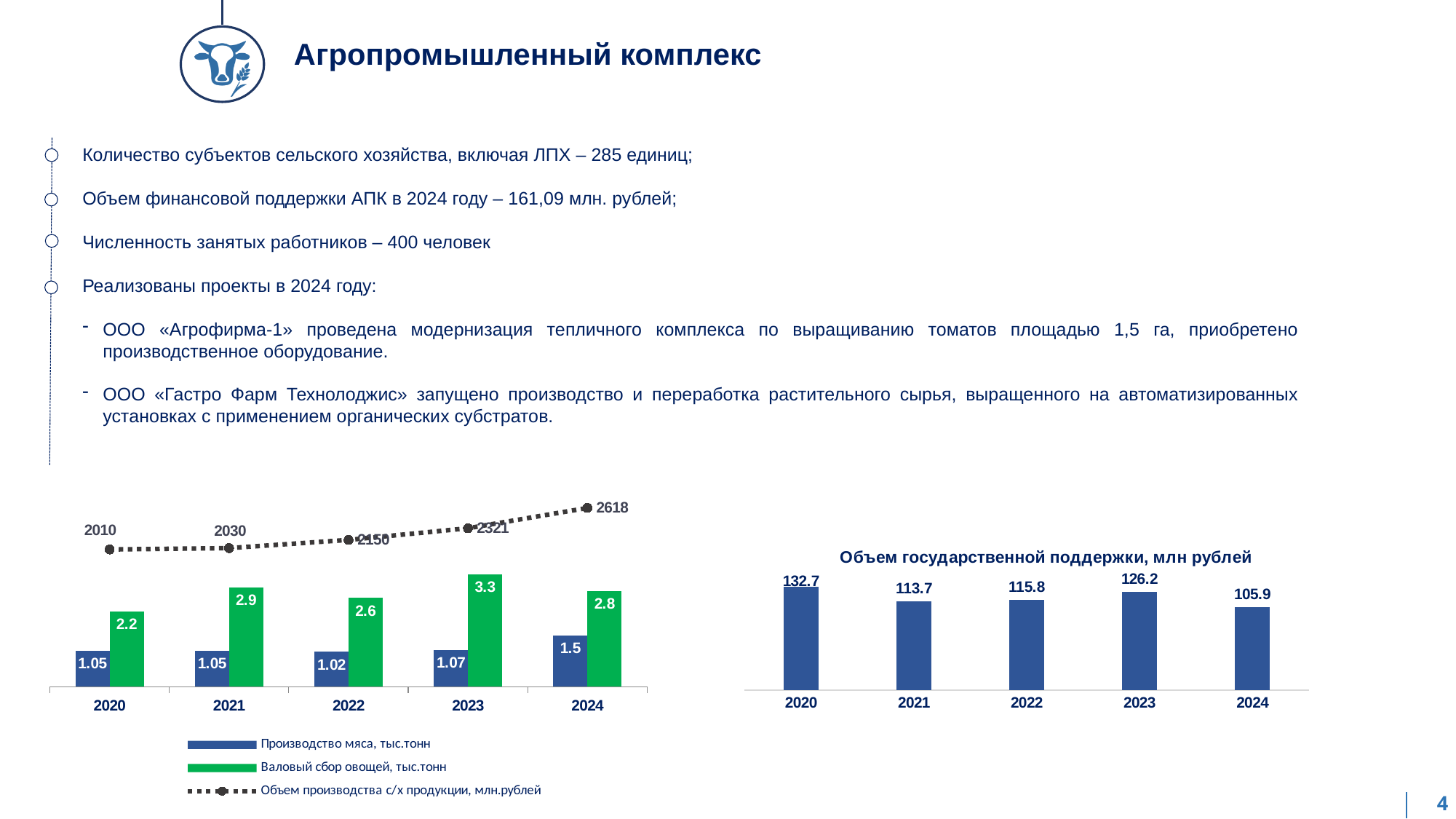
In the bottom-left chart, which is larger: 'Валовый сбор овощей, тыс.тонн' in 2021 or in 2022? 2021 In the bottom-left chart, how many series does the legend list? 3 In the chart titled 'Объем государственной поддержки, млн рублей', what is the value for 2023? 126.2 In the chart titled 'Объем государственной поддержки, млн рублей', which year has the highest value? 2020 In the bottom-left chart, what is the value of 'Производство мяса, тыс.тонн' for 2024? 1.5 In the bottom-left chart, does 'Объем производства с/х продукции, млн.рублей' rise or fall from 2020 to 2024? rise In the bottom-left chart, what is the value of 'Объем производства с/х продукции, млн.рублей' for 2024? 2618 In the chart titled 'Объем государственной поддержки, млн рублей', how many years are shown? 5 In the bottom-left chart, what is the value of 'Валовый сбор овощей, тыс.тонн' for 2023? 3.3 In the chart titled 'Объем государственной поддержки, млн рублей', what is the difference between the values for 2020 and 2024? 26.8 In the bottom-left chart, which year has the lowest value of 'Производство мяса, тыс.тонн'? 2022 In the chart titled 'Объем государственной поддержки, млн рублей', which year has the lowest value? 2024